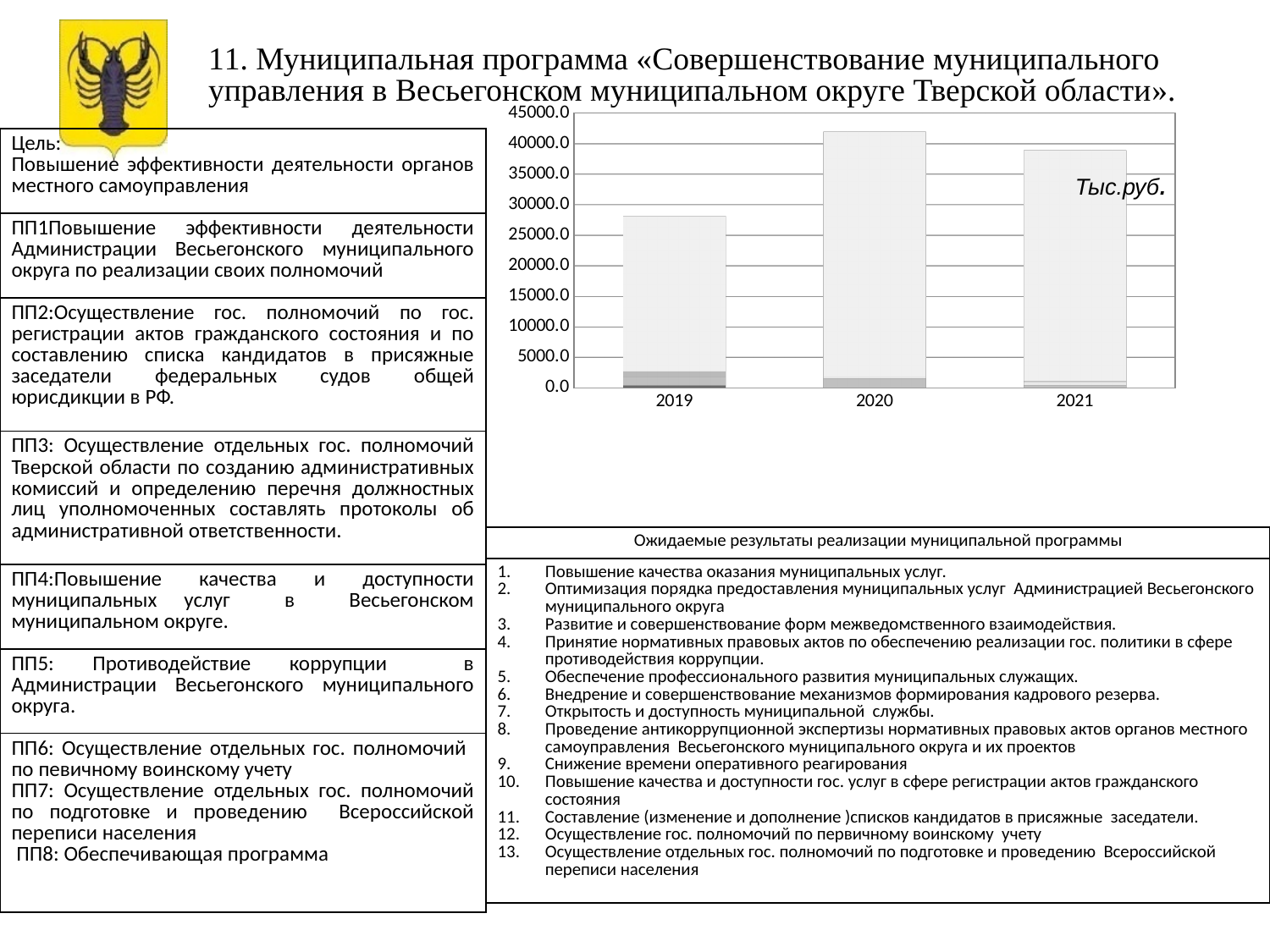
Which year has the shortest bar in the chart? 2019 Is the total bar height for 2019 greater or less than 30000? less Is the total bar height for 2021 greater or less than 35000? greater What unit label is printed inside the chart area? Тыс.руб. How many years (categories) are shown on the x axis of the chart? 3 Is the total bar height for 2019 greater or less than 25000? greater Which year has the tallest bar in the chart? 2020 What kind of chart is shown on the slide? bar chart What is the highest value shown on the chart's y axis? 45000.0 Which bar is taller, 2020 or 2021? 2020 Which bar is taller, 2019 or 2021? 2021